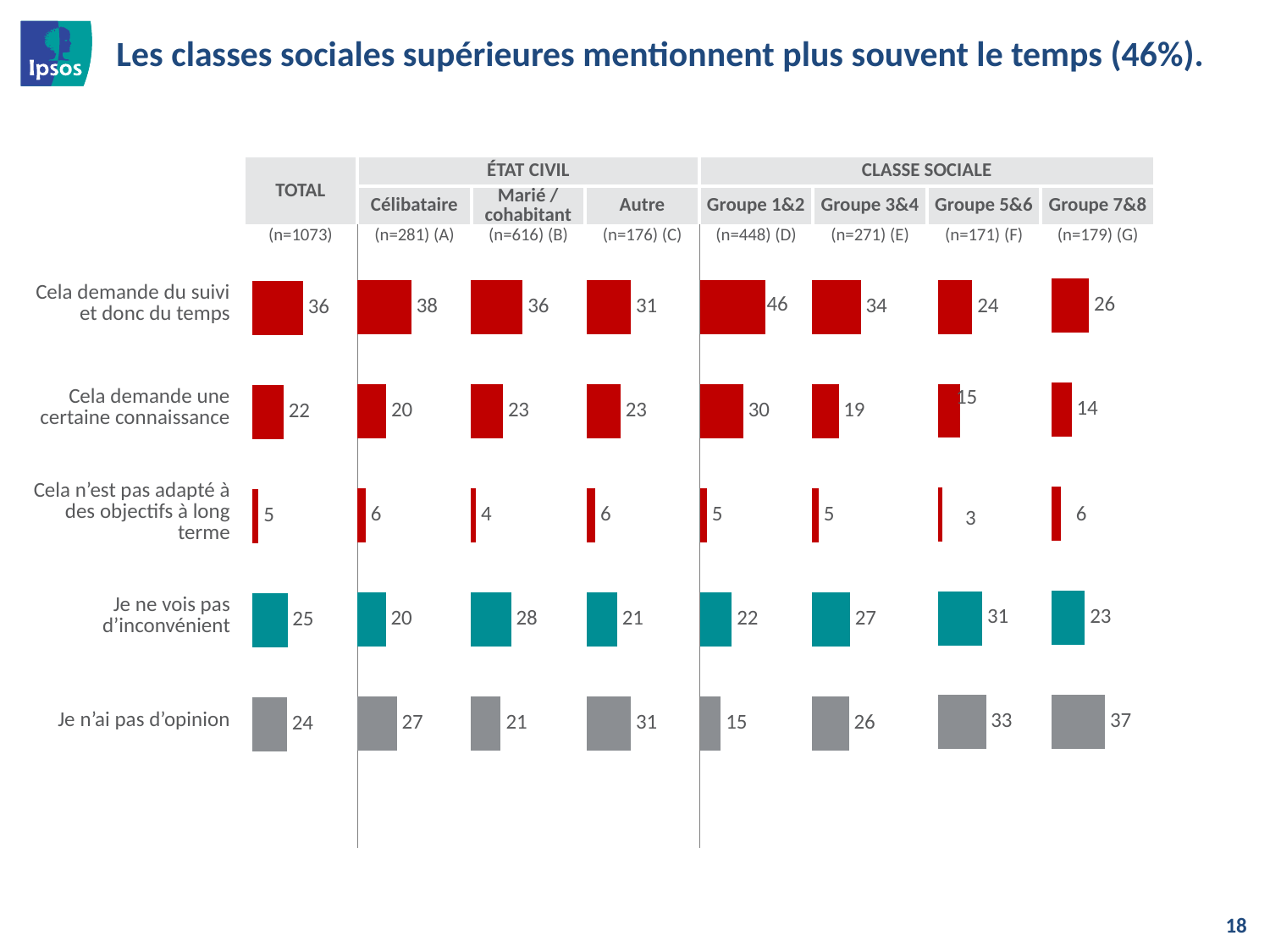
What is the difference between the Groupe 1&2 and Groupe 7&8 values for "Cela demande du suivi et donc du temps"? 20 Across the four CLASSE SOCIALE columns, which group has the highest value for "Cela demande du suivi et donc du temps"? Groupe 1&2 For "Cela demande une certaine connaissance", which is larger: the Groupe 1&2 value or the Groupe 5&6 value? Groupe 1&2 For "Je n'ai pas d'opinion", which is larger: the Autre value or the Marié / cohabitant value? Autre How many statements (rows) are plotted in the chart? 5 What type of chart is used on this slide? Bar chart In the TOTAL column, what is the value for "Cela demande du suivi et donc du temps"? 36 How many columns of bars are shown in the chart, including TOTAL? 8 In the Marié / cohabitant column, what is the value for "Je ne vois pas d'inconvénient"? 28 In the Groupe 1&2 column, what is the value for "Cela demande du suivi et donc du temps"? 46 In the Groupe 7&8 column, what is the value for "Je n'ai pas d'opinion"? 37 In the TOTAL column, which statement has the lowest value? Cela n'est pas adapté à des objectifs à long terme